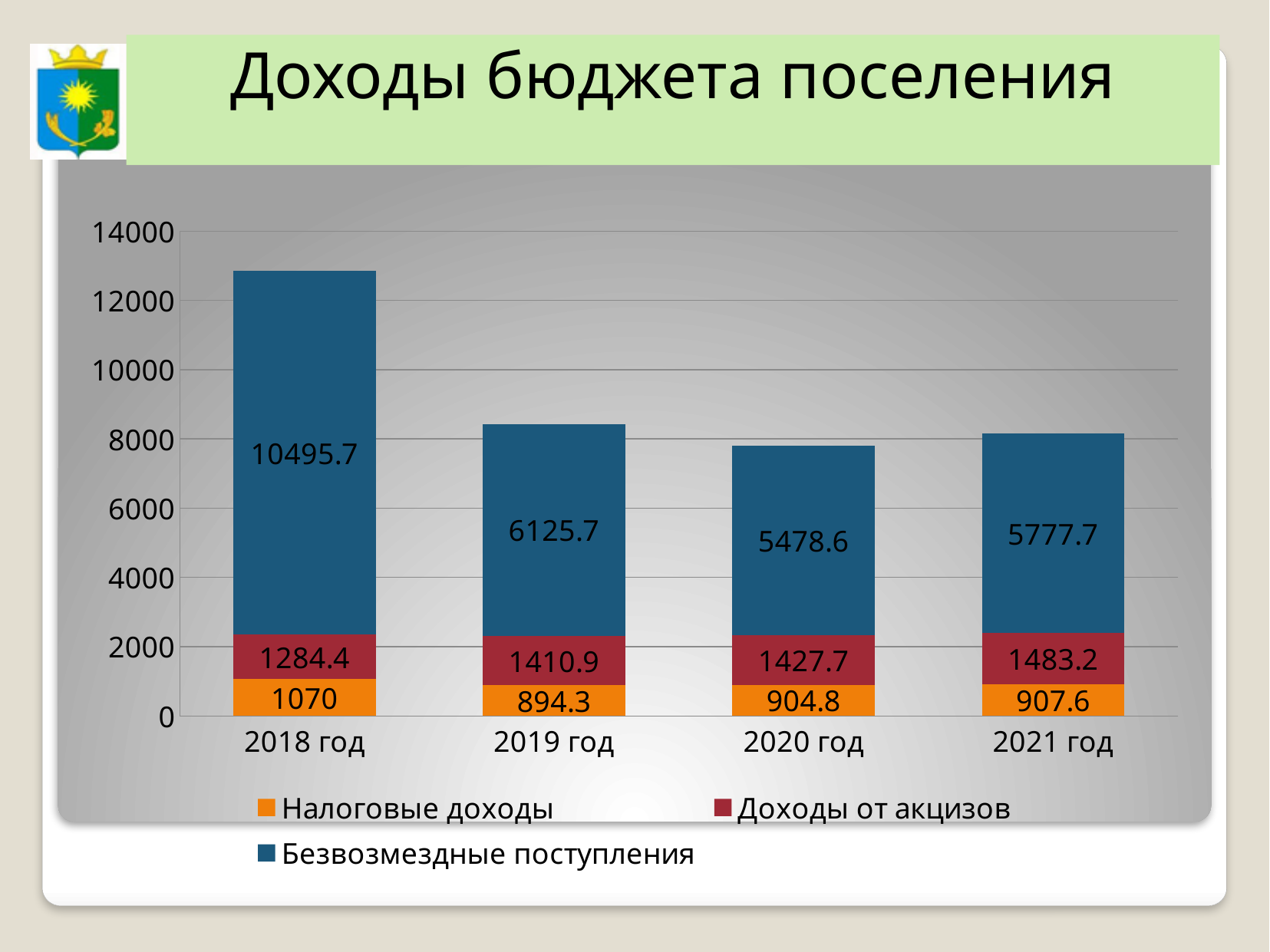
What is the title of the chart? Доходы бюджета поселения What kind of chart is shown on the slide? Stacked bar chart What is the value of Безвозмездные поступления for 2018 год? 10495.7 What is the value of Доходы от акцизов for 2021 год? 1483.2 How many years are shown on the x axis? 4 What is the total of the stacked bar for 2020 год? 7811.1 In which year is Налоговые доходы the lowest? 2019 год What is the value of Налоговые доходы for 2019 год? 894.3 How many series does the legend list? 3 In which year is Безвозмездные поступления the highest? 2018 год What is the difference between Безвозмездные поступления in 2018 год and 2019 год? 4370 Which is larger: Доходы от акцизов in 2020 год or in 2021 год? 2021 год